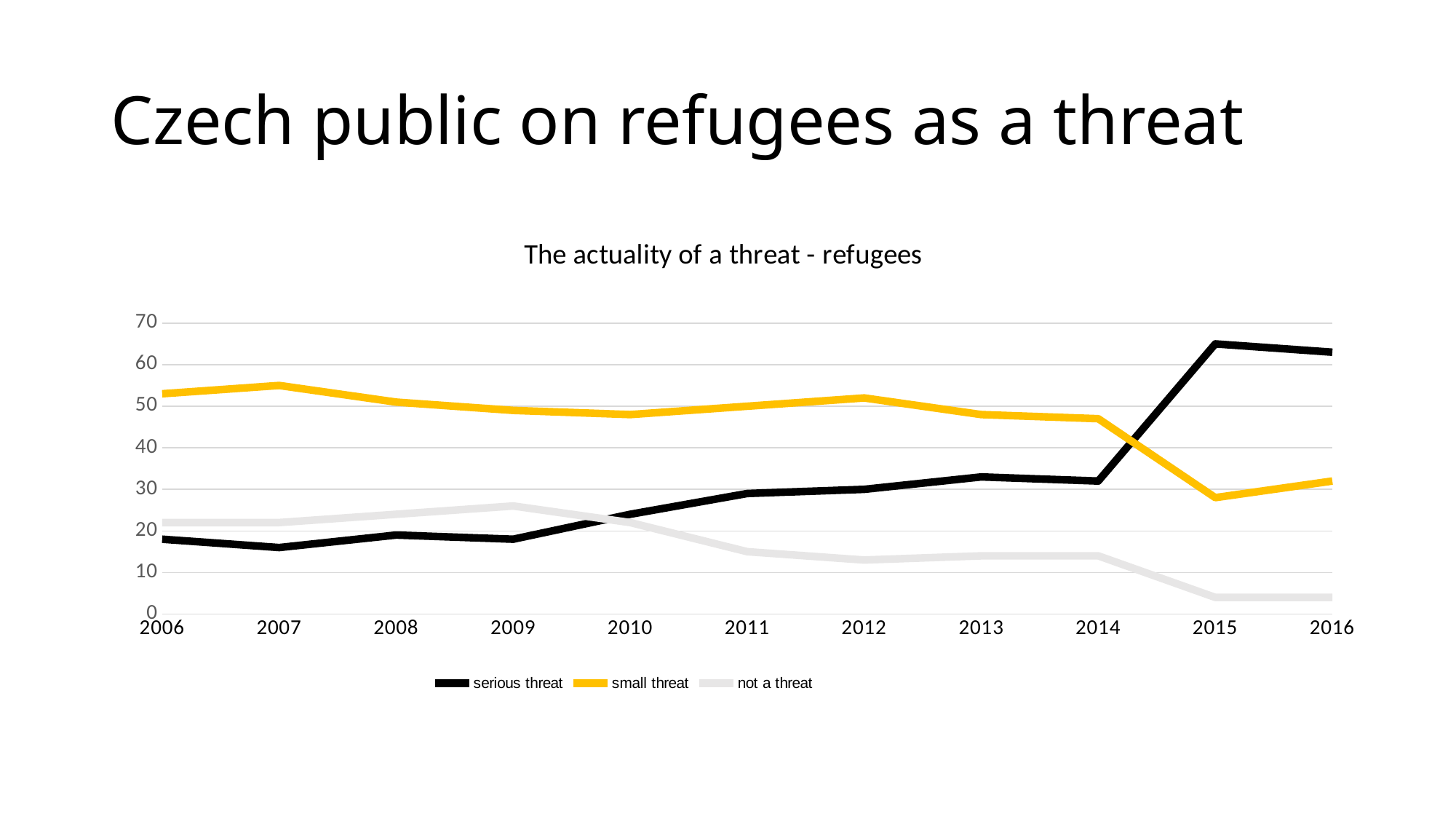
In which year is the value for 'not a threat' highest? 2009 What is the title of the chart? The actuality of a threat - refugees What kind of chart is shown on the slide? line chart Is the value for 'small threat' in 2015 greater or less than 40? less Does the 'not a threat' series rise or fall overall from 2006 to 2016? fall Is the value for 'serious threat' in 2015 greater or less than 60? greater In 2016, which is larger: 'serious threat' or 'small threat'? serious threat Is the value for 'not a threat' in 2016 greater or less than 10? less How many series does the legend list? 3 How many years are shown on the x axis? 11 In which year is the value for 'serious threat' highest? 2015 In 2014, which is larger: 'serious threat' or 'small threat'? small threat